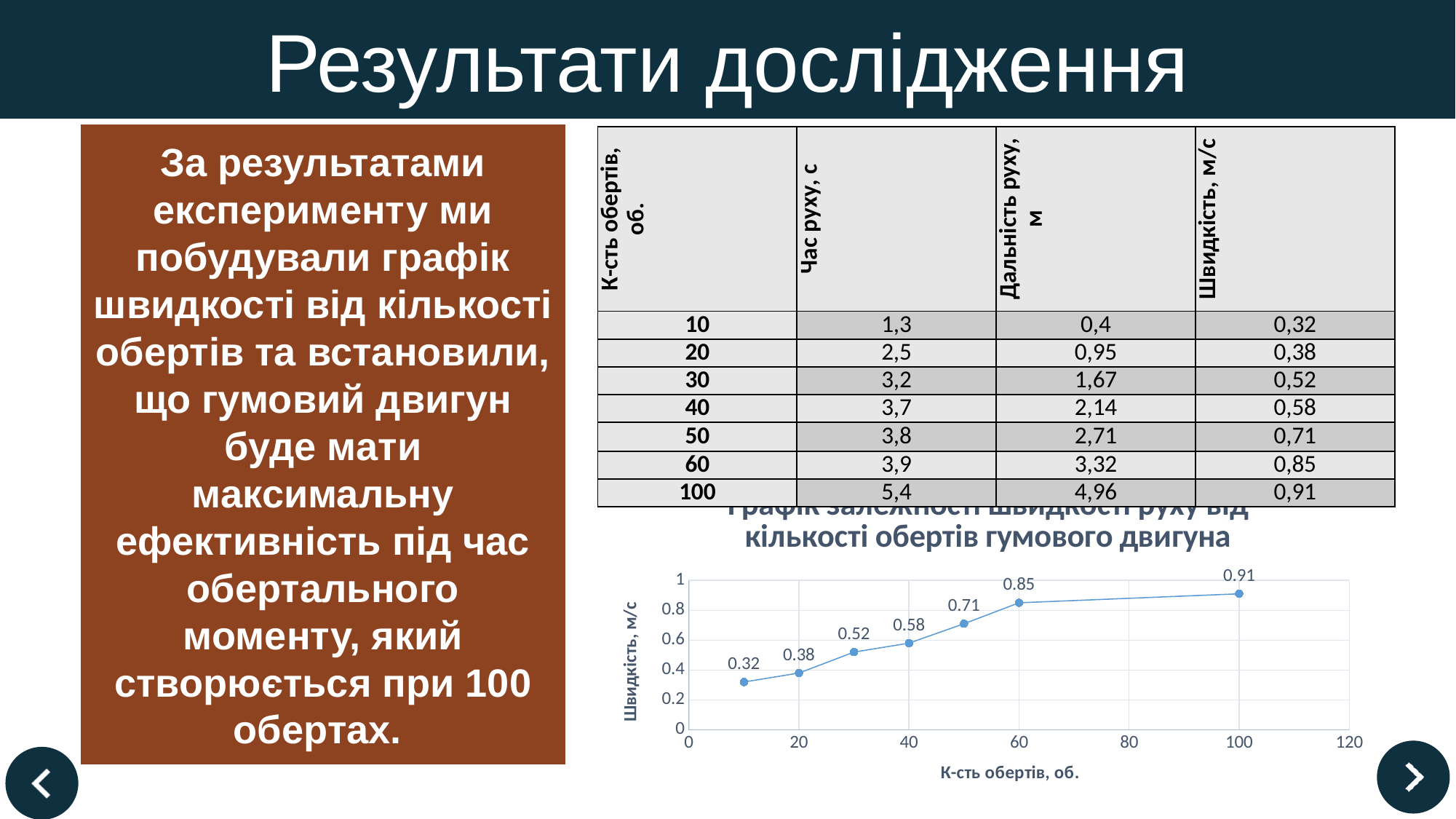
What is the speed value plotted at 100 revolutions? 0.91 What is the difference between the speed at 60 revolutions and the speed at 40 revolutions? 0.27 What is the speed value plotted at 50 revolutions? 0.71 What kind of chart is shown on the slide? Line chart How many data points are plotted on the chart? 7 What is the speed value plotted at 10 revolutions? 0.32 Is the speed value at 60 revolutions greater or less than 0.8? greater At which number of revolutions is the plotted speed lowest? 10 Do the plotted speed values rise or fall as the number of revolutions increases? Rise What is the label of the vertical axis of the chart? Швидкість, м/с Which is larger: the speed at 30 revolutions or the speed at 20 revolutions? 30 revolutions At which number of revolutions is the plotted speed highest? 100